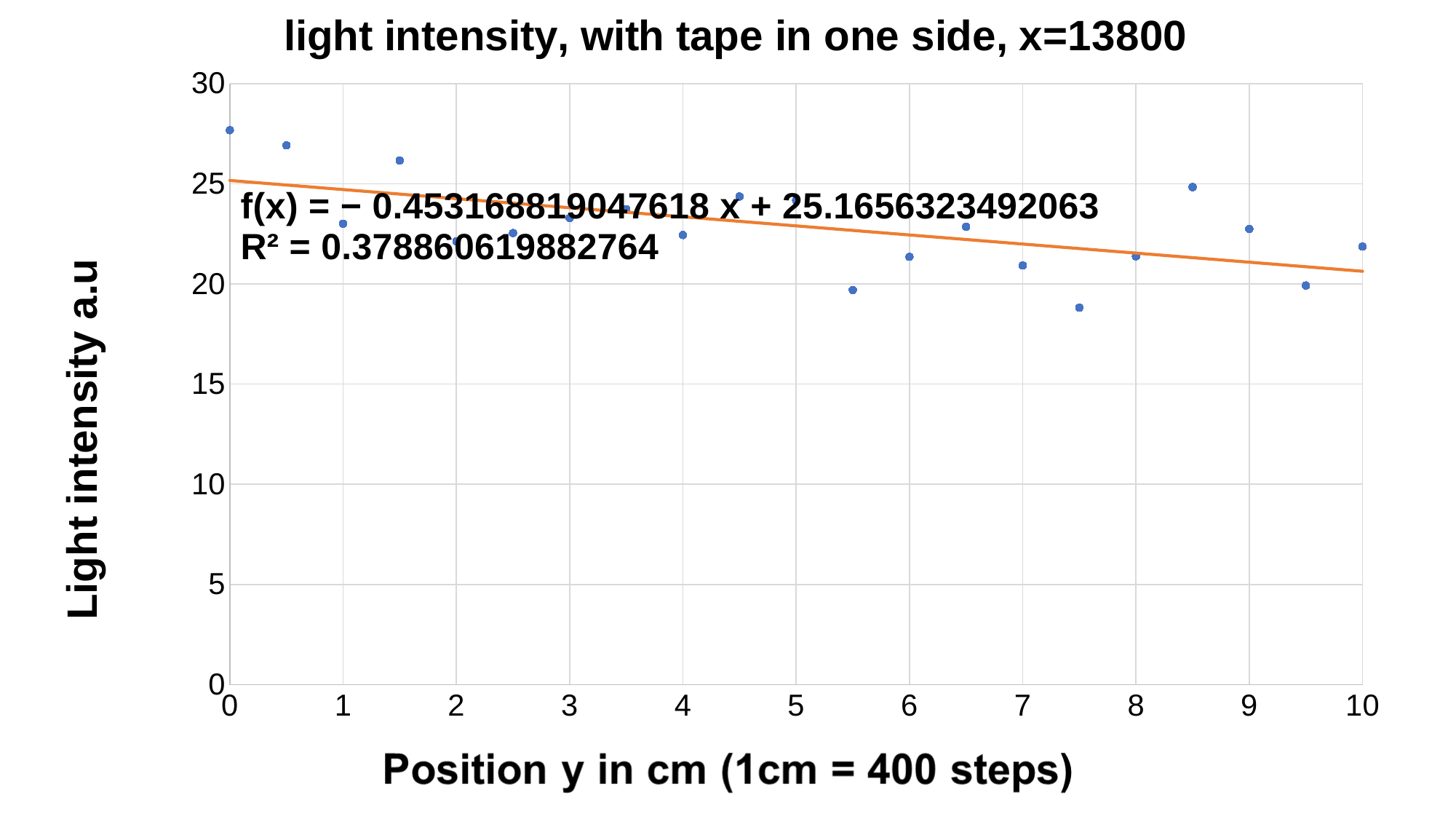
At which position y is the light intensity highest? 0 Which has the higher light intensity, position y = 5.5 or position y = 8.5? 8.5 Do the light intensity values generally rise or fall as position y increases from 0 to 10 cm? fall What kind of chart is shown on the slide? scatter chart Is the light intensity at position y = 7.5 greater or less than 20? less What is the title of the chart? light intensity, with tape in one side, x=13800 Is the light intensity at position y = 8.5 greater or less than 20? greater Is the light intensity at position y = 0 greater or less than 25? greater What is the R² value shown on the chart? 0.378860619882764 Which has the higher light intensity, position y = 1.5 or position y = 7? 1.5 At which position y is the light intensity lowest? 7.5